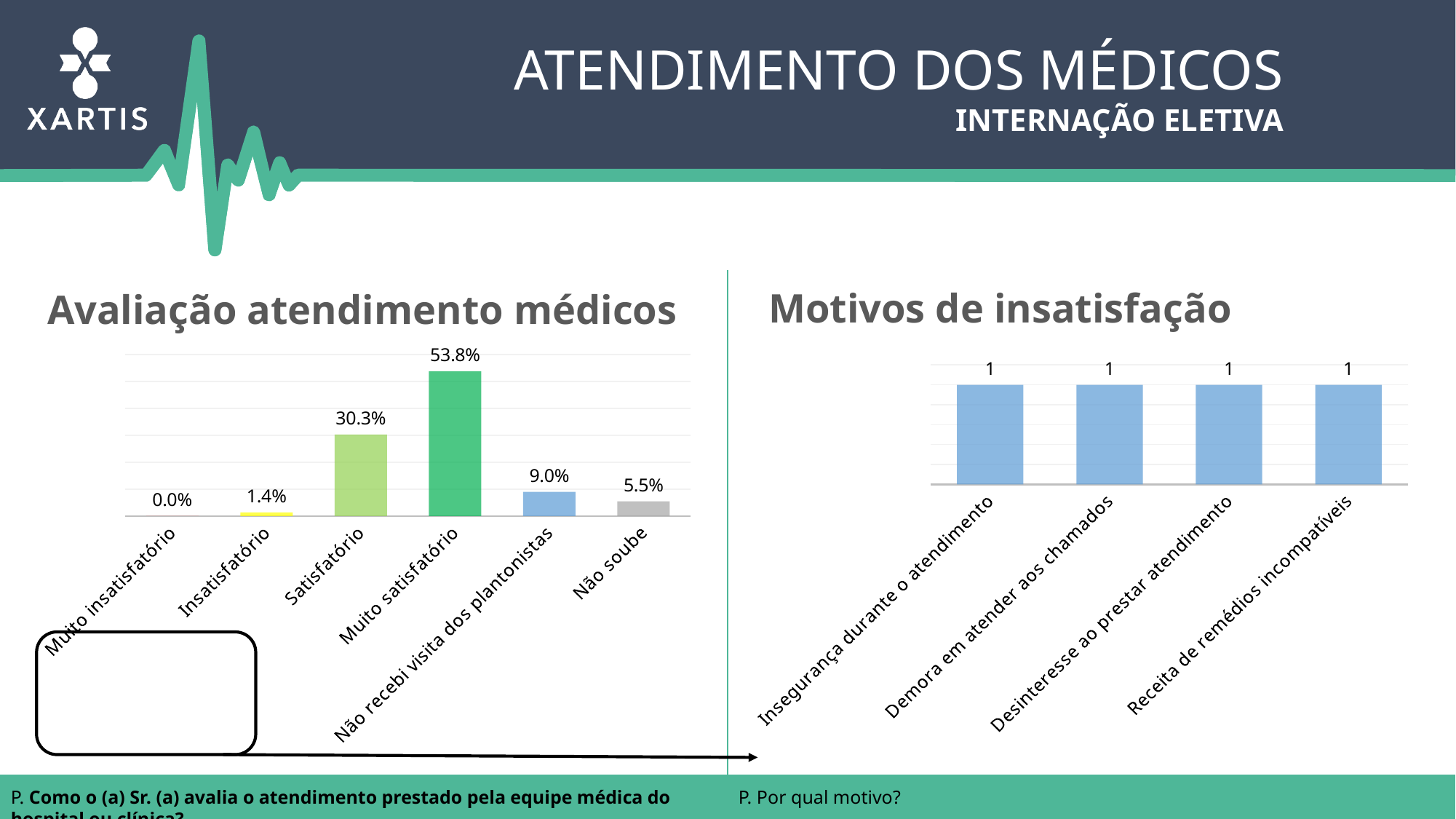
In the 'Avaliação atendimento médicos' chart, which category has the lowest value? Muito insatisfatório In the 'Avaliação atendimento médicos' chart, which is larger: Não recebi visita dos plantonistas or Não soube? Não recebi visita dos plantonistas In the 'Avaliação atendimento médicos' chart, what is the value for Satisfatório? 30.3% In the 'Avaliação atendimento médicos' chart, what is the value for Insatisfatório? 1.4% In the 'Motivos de insatisfação' chart, what is the value for Receita de remédios incompatíveis? 1 What kind of chart is the 'Motivos de insatisfação' chart? Bar chart In the 'Avaliação atendimento médicos' chart, what is the value for Muito satisfatório? 53.8% In the 'Avaliação atendimento médicos' chart, which category has the highest value? Muito satisfatório In the 'Avaliação atendimento médicos' chart, what is the difference between Muito satisfatório and Satisfatório? 23.5% How many categories are shown in the 'Motivos de insatisfação' chart? 4 How many categories are shown in the 'Avaliação atendimento médicos' chart? 6 In the 'Avaliação atendimento médicos' chart, what is the value for Não recebi visita dos plantonistas? 9.0%